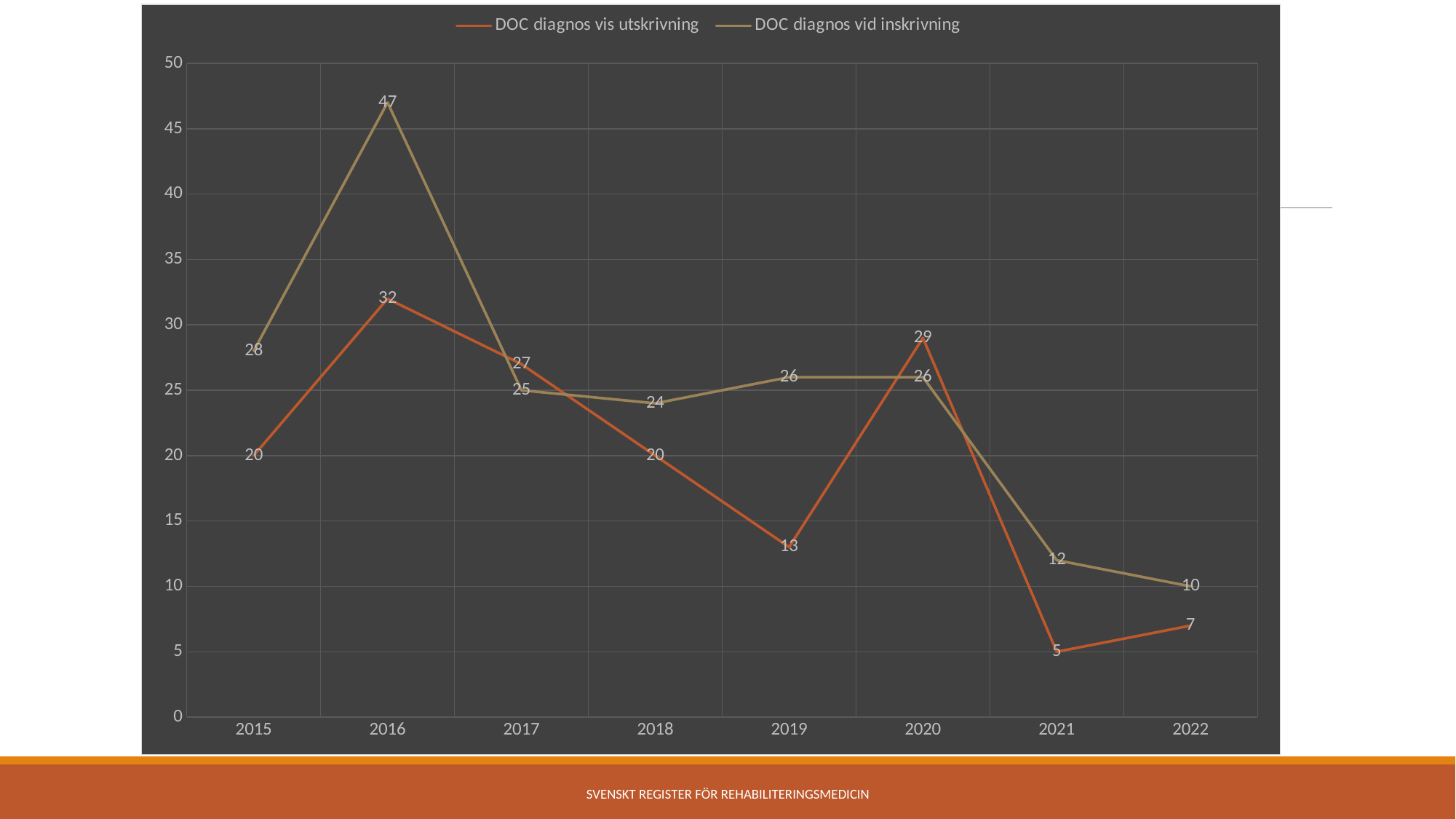
What is the difference between DOC diagnos vid inskrivning and DOC diagnos vis utskrivning in 2016? 15 How many years are shown on the x axis? 8 In which year is DOC diagnos vis utskrivning highest? 2016 What is the value for DOC diagnos vis utskrivning in 2019? 13 Does DOC diagnos vid inskrivning rise or fall from 2020 to 2022? fall What type of chart is shown on the slide? line chart In which year is DOC diagnos vis utskrivning lowest? 2021 What colour is the line for DOC diagnos vis utskrivning? orange Which series has the larger value in 2020, DOC diagnos vis utskrivning or DOC diagnos vid inskrivning? DOC diagnos vis utskrivning What is the value for DOC diagnos vid inskrivning in 2022? 10 How many series does the legend list? 2 What is the value for DOC diagnos vid inskrivning in 2016? 47